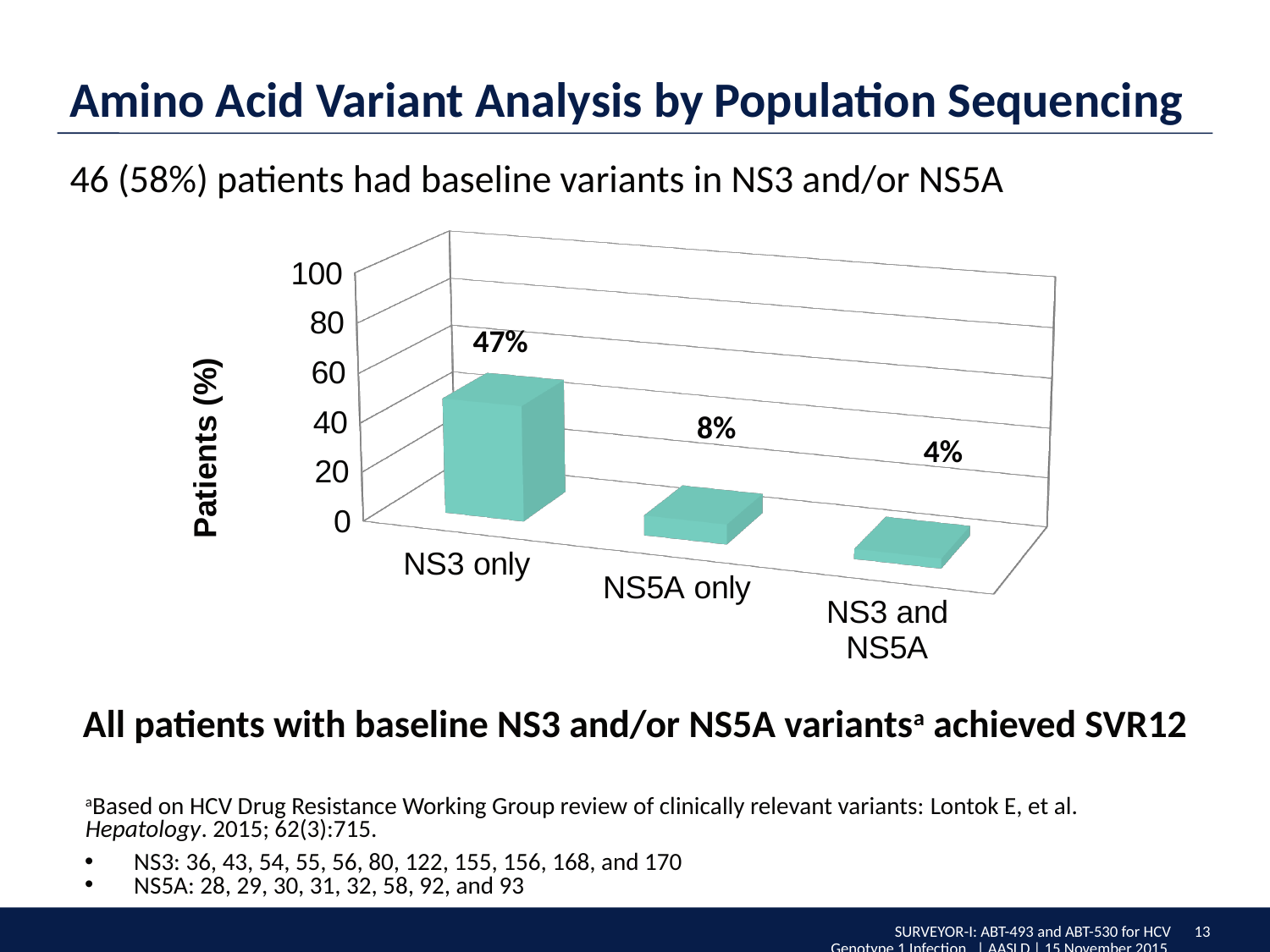
Which category has the highest percentage of patients? NS3 only How many categories are shown on the x axis of the chart? 3 Which category has the lowest percentage of patients? NS3 and NS5A What percentage of patients had variants in both NS3 and NS5A? 4% What kind of chart is shown on the slide? bar chart What is the difference in percentage points between NS3 only and NS5A only? 39 What percentage of patients had variants in NS5A only? 8% Is the value for NS3 only greater or less than 40? greater What is the difference in percentage points between NS5A only and NS3 and NS5A? 4 What percentage of patients had variants in NS3 only? 47% What is the label of the vertical axis of the chart? Patients (%) Which is larger, the value for NS5A only or the value for NS3 and NS5A? NS5A only